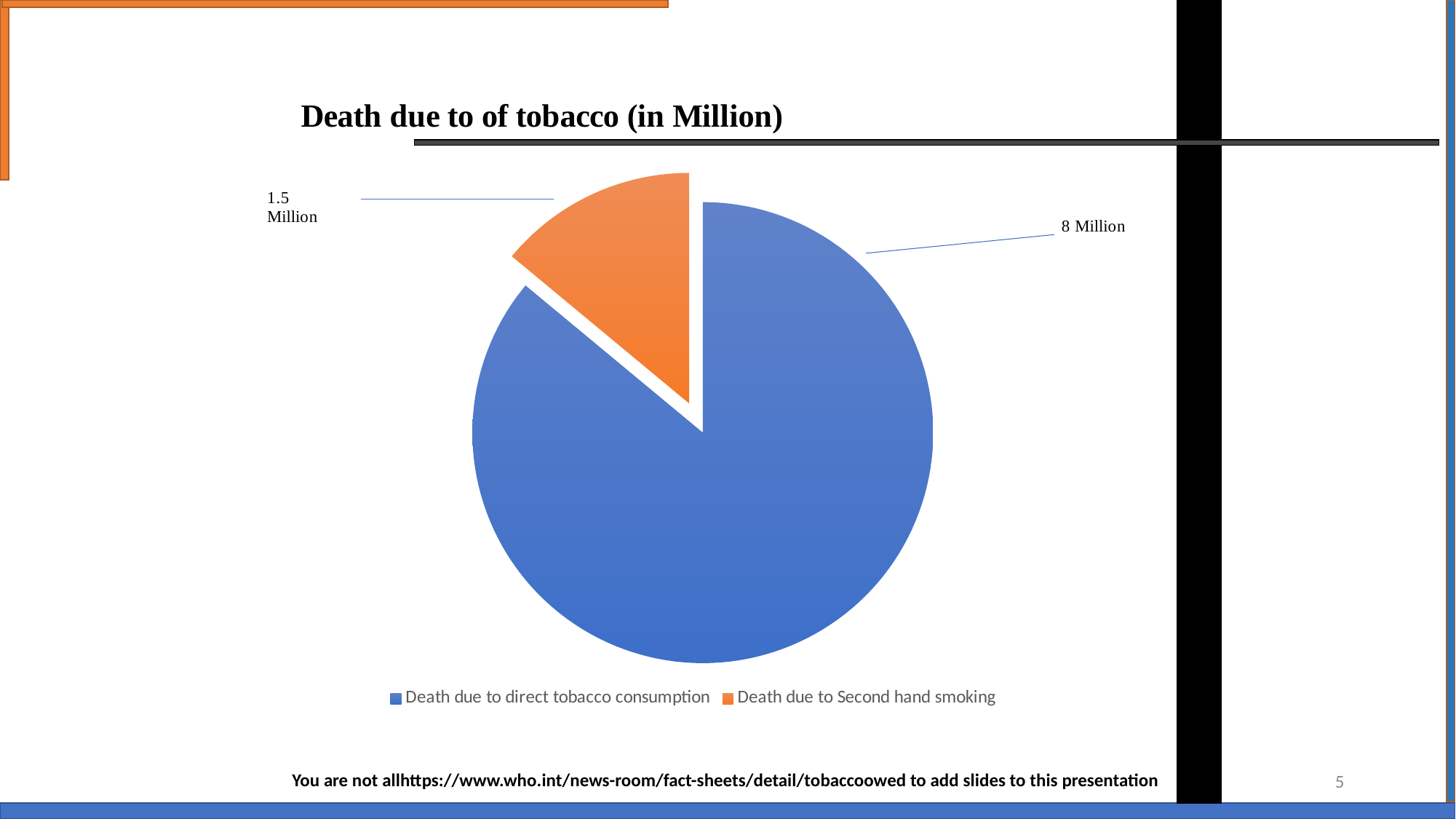
Which category has the smallest slice of the pie? Death due to Second hand smoking Which is larger: deaths due to direct tobacco consumption or deaths due to second hand smoking? Death due to direct tobacco consumption Which category has the largest slice of the pie? Death due to direct tobacco consumption What is the value for Death due to direct tobacco consumption? 8 Million What is the difference between deaths due to direct tobacco consumption and deaths due to second hand smoking? 6.5 Million What colour is the slice for Death due to Second hand smoking? orange What kind of chart is shown on the slide? pie chart What is the title of the chart? Death due to of tobacco (in Million) How many entries does the legend list? 2 What is the total of the two values shown in the pie chart? 9.5 Million What is the value for Death due to Second hand smoking? 1.5 Million How many slices does the pie chart have? 2